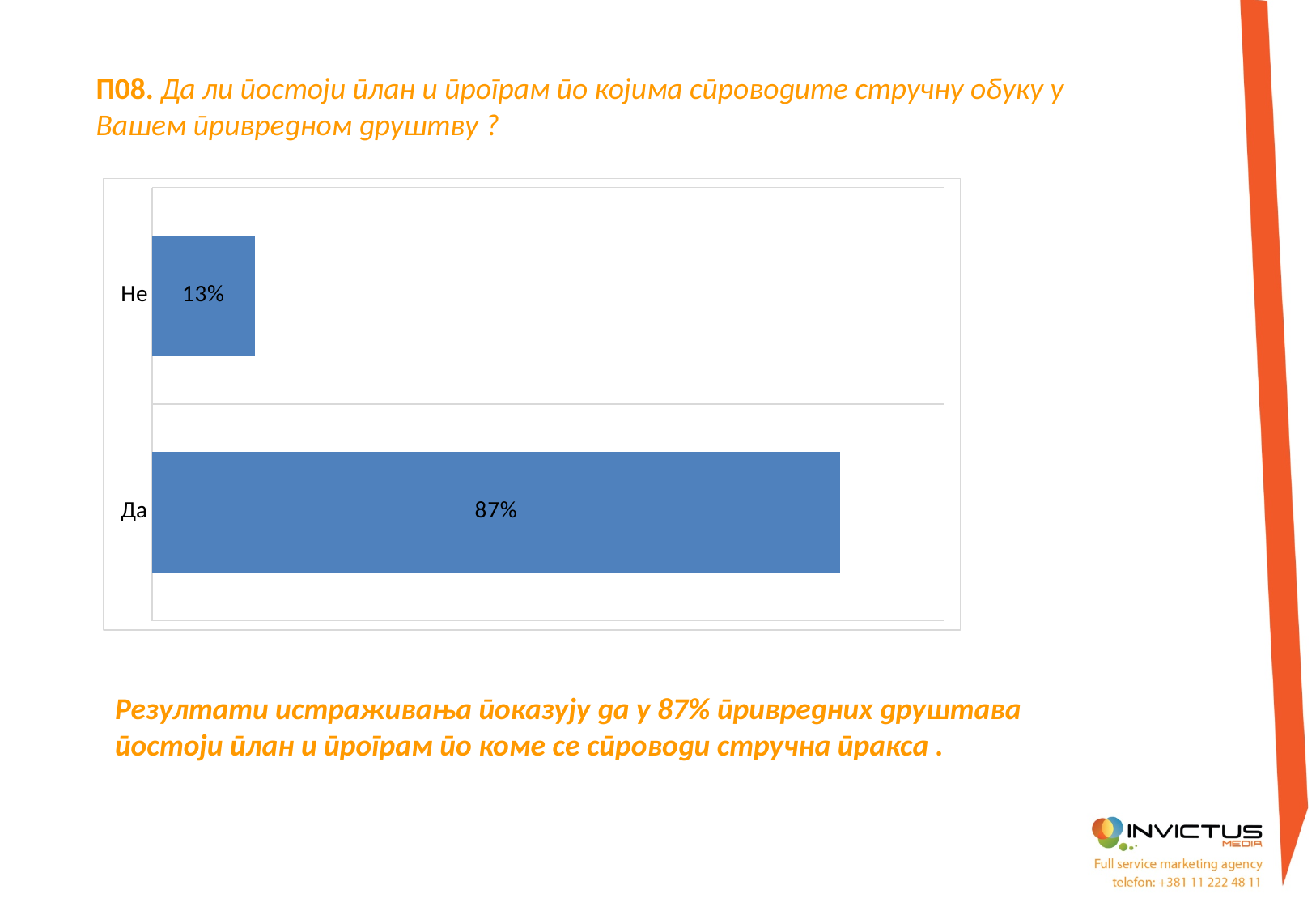
Are the bars in the chart horizontal or vertical? Horizontal What is the value for the category "Не"? 13% What is the total of the two values shown in the chart? 100% What colour are the bars in the chart? Blue What is the difference between the values for "Да" and "Не"? 74% Which is larger, the value for "Да" or the value for "Не"? Да Which category has the lowest value? Не What is the value for the category "Да"? 87% How many categories are shown in the chart? 2 What kind of chart is shown on the slide? Bar chart Which category has the highest value? Да